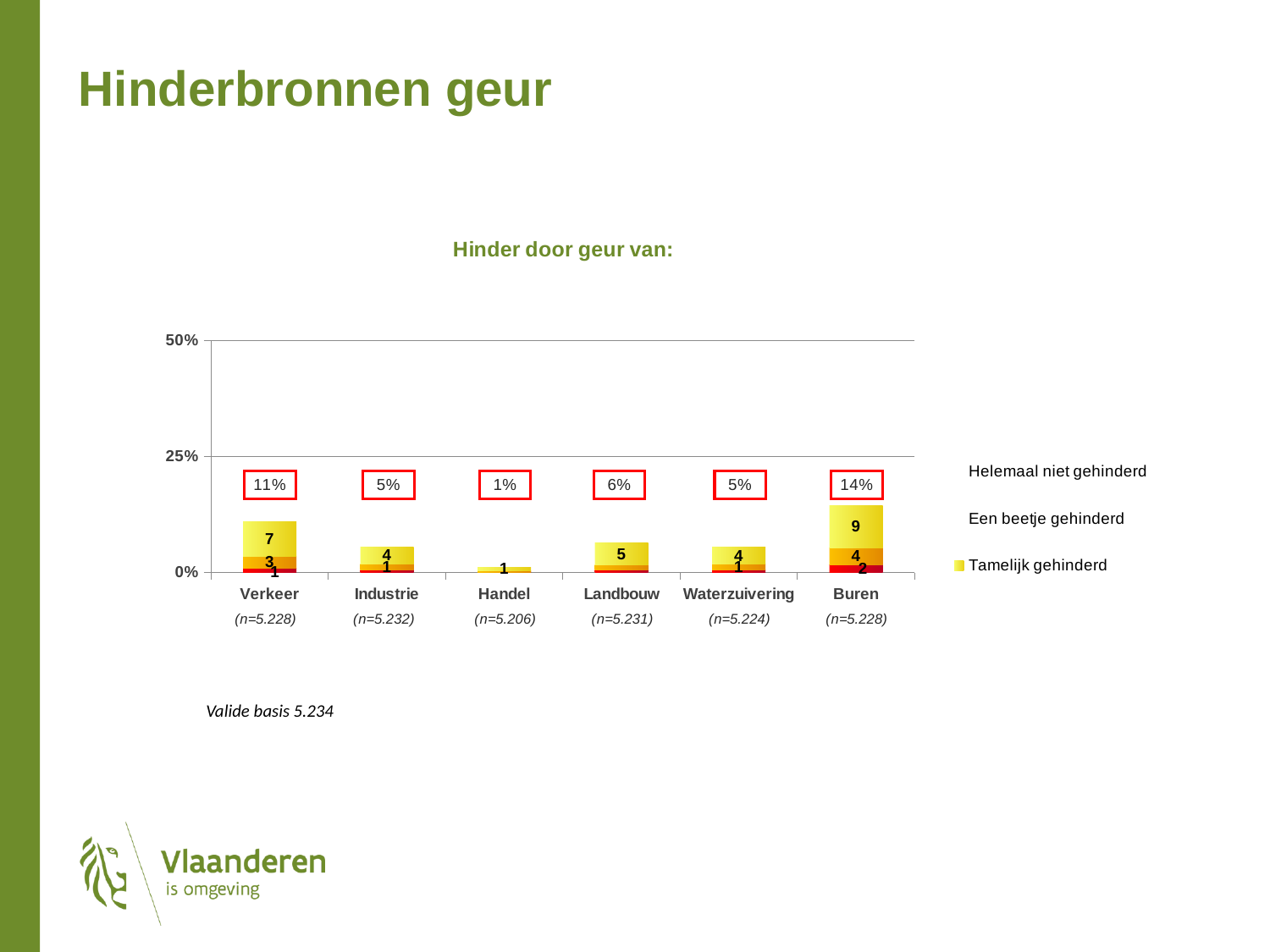
What is the boxed percentage shown above the Buren bar? 14% Which has a higher boxed percentage, Verkeer or Landbouw? Verkeer What is the difference between the boxed percentages for Buren and Verkeer? 3 percentage points What is the largest segment value labelled on the Buren bar? 9 Which category has the lowest boxed percentage? Handel What is the boxed percentage shown above the Landbouw bar? 6% How many entries does the legend list? 3 How many categories are shown on the x axis? 6 What type of chart is shown on the slide? stacked bar chart What is the boxed percentage shown above the Verkeer bar? 11% Which category has the highest boxed percentage? Buren Is the boxed value for Buren greater or less than 25%? less